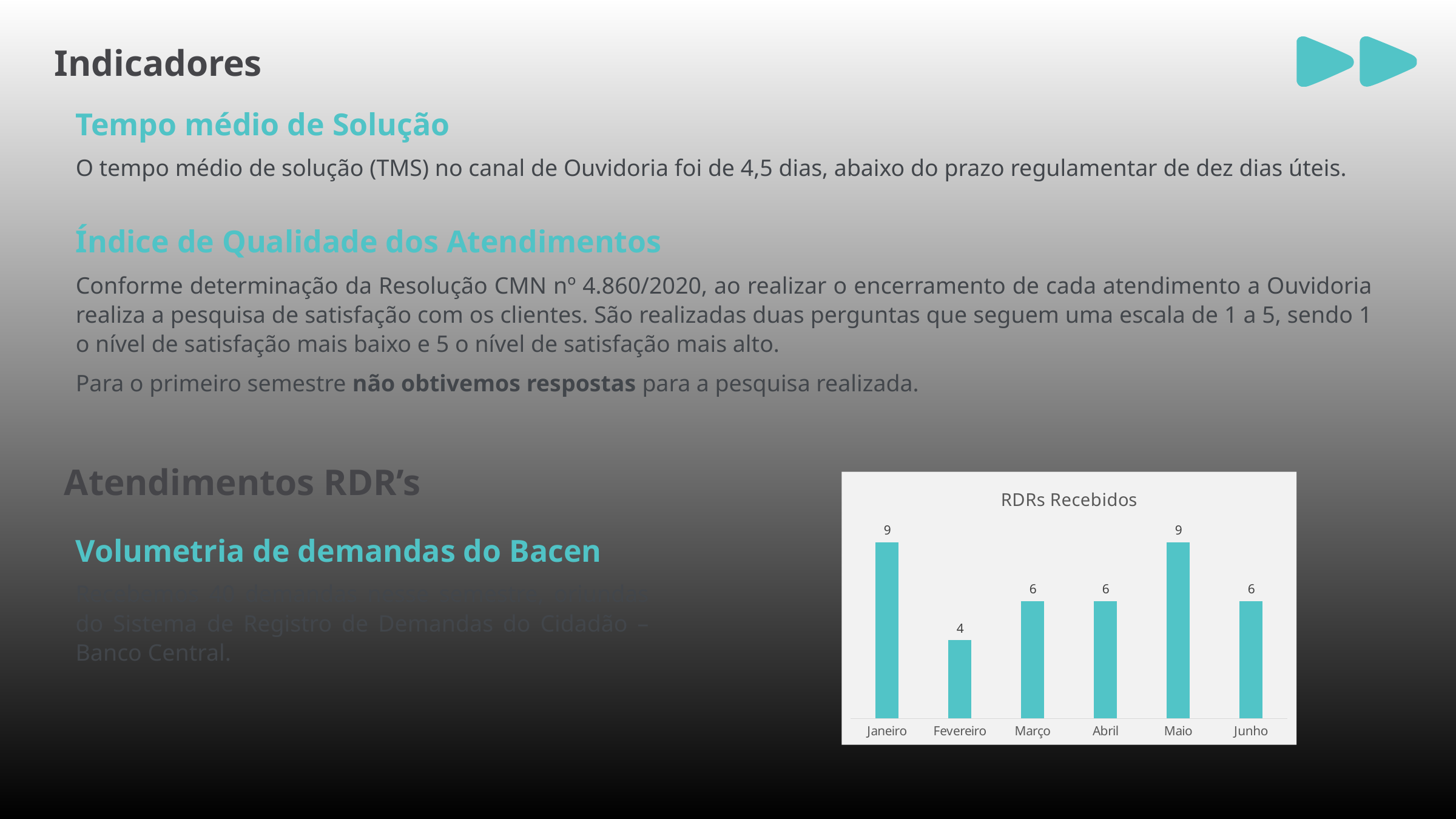
What is the title of the chart on the slide? RDRs Recebidos What is the difference between the values for Janeiro and Fevereiro in the RDRs Recebidos chart? 5 What is the difference between the values for Maio and Junho in the RDRs Recebidos chart? 3 What is the value for Junho in the RDRs Recebidos chart? 6 How many months are shown in the RDRs Recebidos chart? 6 What is the total of all values shown in the RDRs Recebidos chart? 40 Which is larger in the RDRs Recebidos chart, the value for Março or the value for Fevereiro? Março What is the value for Abril in the RDRs Recebidos chart? 6 What is the value for Janeiro in the RDRs Recebidos chart? 9 What is the value for Fevereiro in the RDRs Recebidos chart? 4 Which month has the lowest value in the RDRs Recebidos chart? Fevereiro What kind of chart is the RDRs Recebidos chart? Bar chart